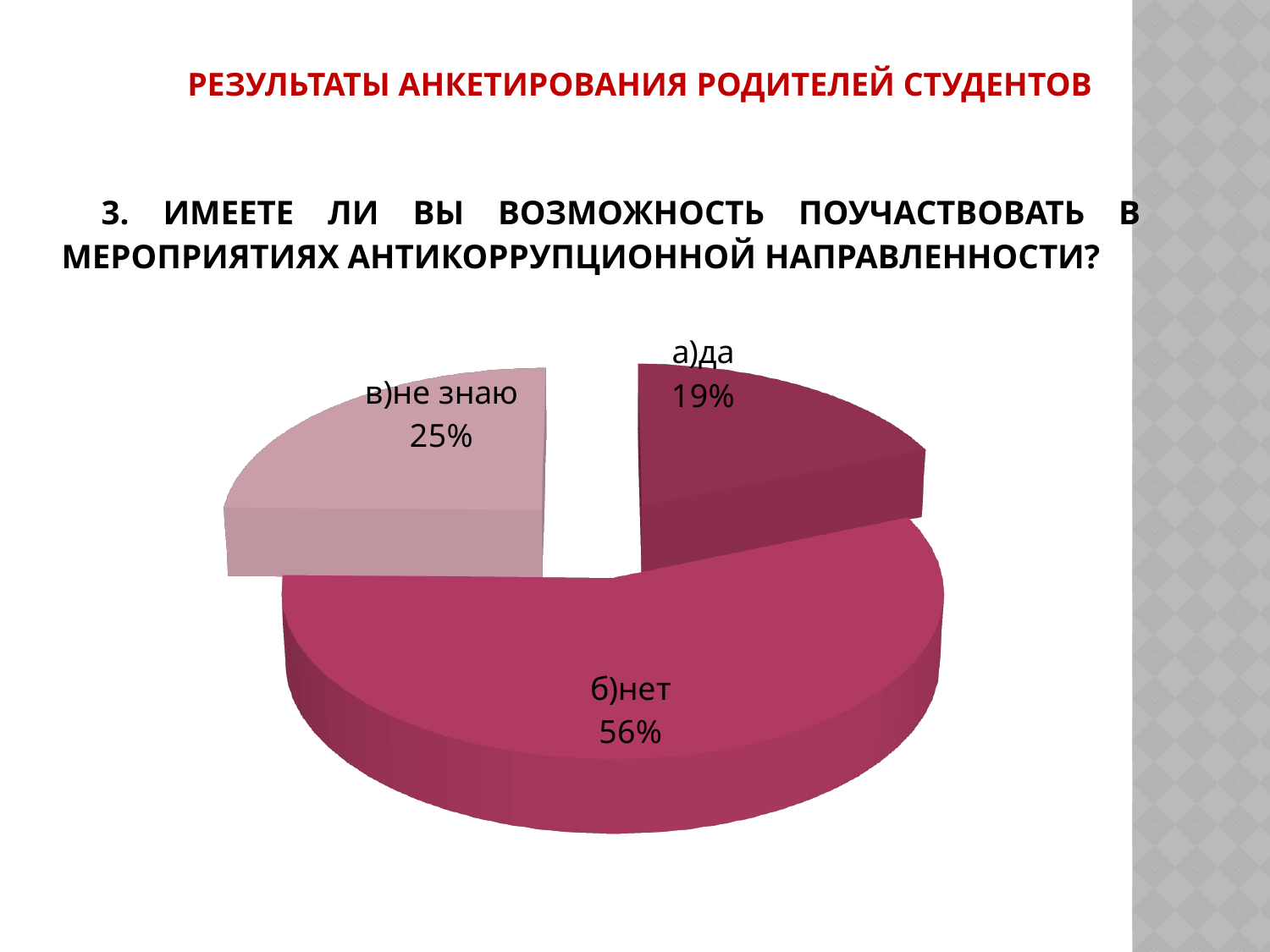
Which answer has the smallest share of the pie? а)да Which answer has the largest share of the pie? б)нет What is the difference in percentage points between "б)нет" and "а)да"? 37 What percentage of respondents answered "б)нет"? 56% Which is larger, the share for "в)не знаю" or the share for "а)да"? в)не знаю What kind of chart is shown on the slide? pie chart How many slices does the pie chart have? 3 What is the difference in percentage points between "в)не знаю" and "а)да"? 6 What percentage of respondents answered "в)не знаю"? 25% What percentage of respondents answered "а)да"? 19% Which slice of the pie is shown in the lightest pink colour? в)не знаю What share of the pie does the "б)нет" slice represent? 56%